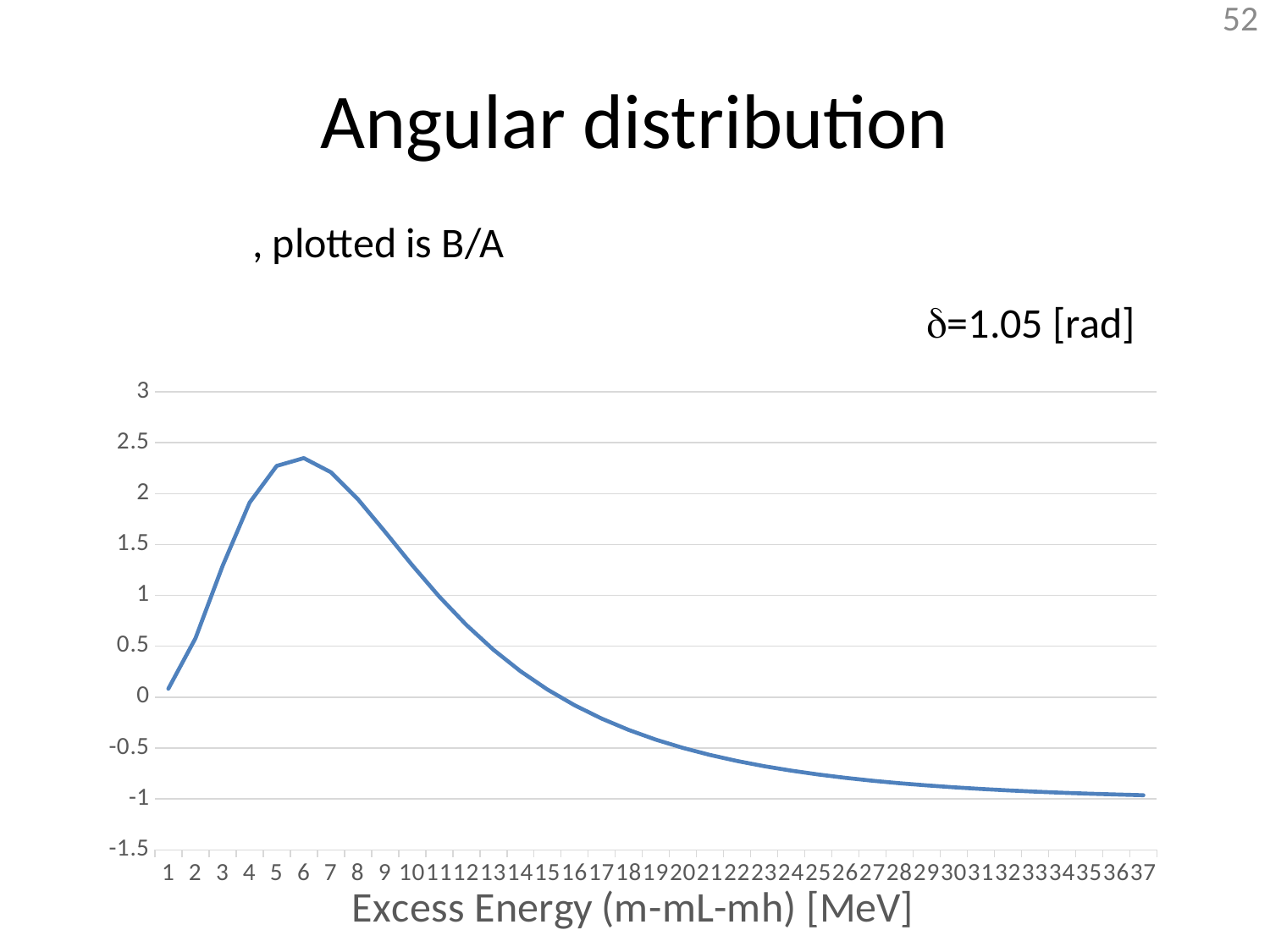
At which x-axis value does the curve reach its highest point? 6 Is the value at x = 10 greater or less than 1? greater Do the values rise or fall along the x axis from x = 6 to x = 37? fall Is the value at x = 37 greater or less than -0.5? less What kind of chart is shown on the slide? line chart What is the x-axis title of the chart? Excess Energy (m-mL-mh) [MeV] Which has the larger value, x = 4 or x = 10? x = 4 Is the value at x = 1 greater or less than 0.5? less What value of δ is stated above the chart? 1.05 [rad] How many points are plotted along the x axis? 37